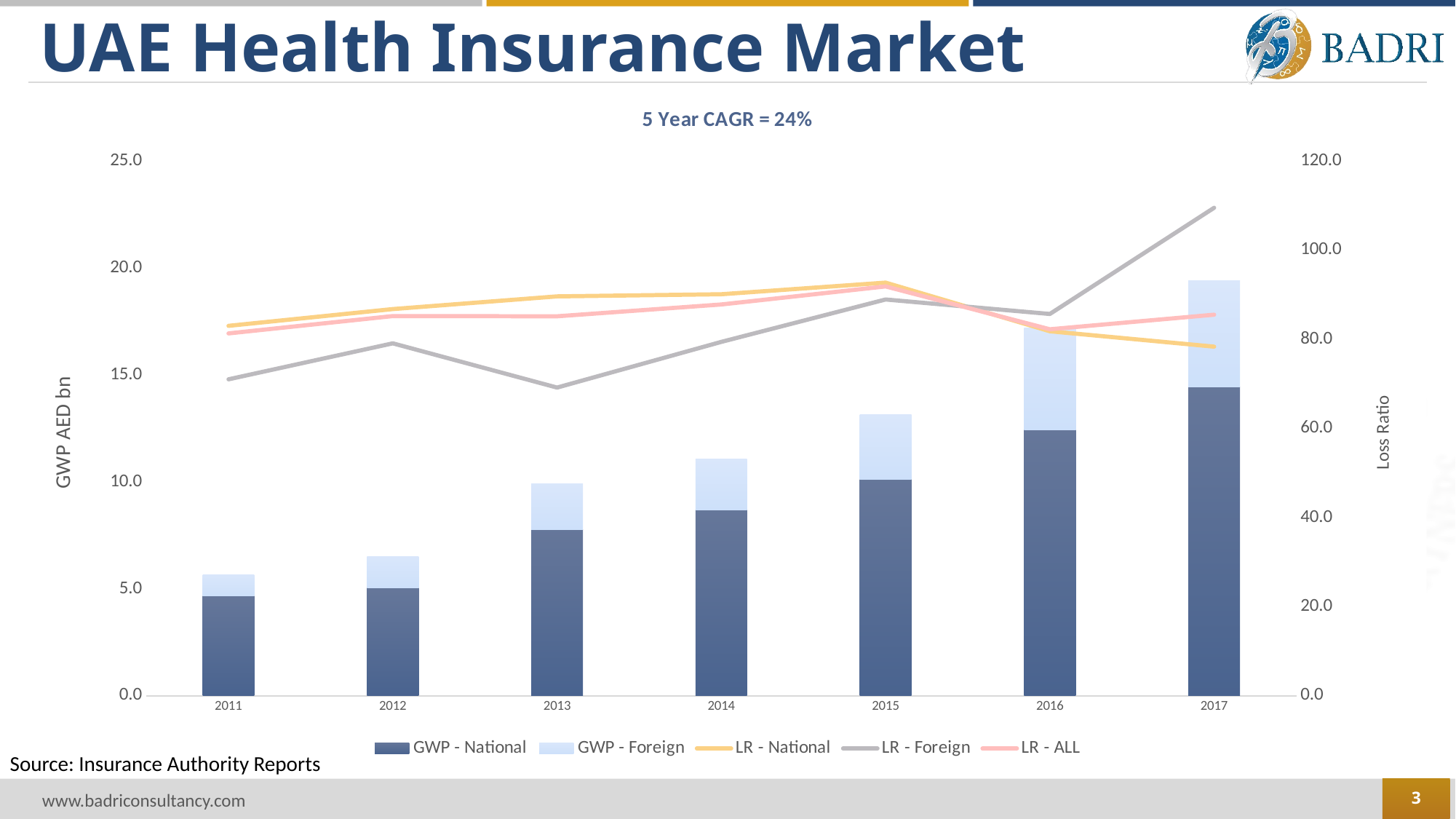
Which year has the lowest GWP - National bar? 2011 Is the LR - Foreign value for 2017 greater or less than 100.0? greater What is the label of the left vertical axis? GWP AED bn Is the GWP - National value for 2017 greater or less than 10.0? greater What kind of chart is shown on the slide? A combination chart of stacked bars and lines How many years are shown on the x axis of the chart? 7 What is the title shown above the chart? 5 Year CAGR = 24% Do the GWP - National bars rise or fall from 2011 to 2017? Rise Which year has the highest GWP - National bar? 2017 In 2017, which is larger, LR - Foreign or LR - National? LR - Foreign How many series does the chart legend list? 5 Is the LR - Foreign value for 2013 greater or less than 80.0? less